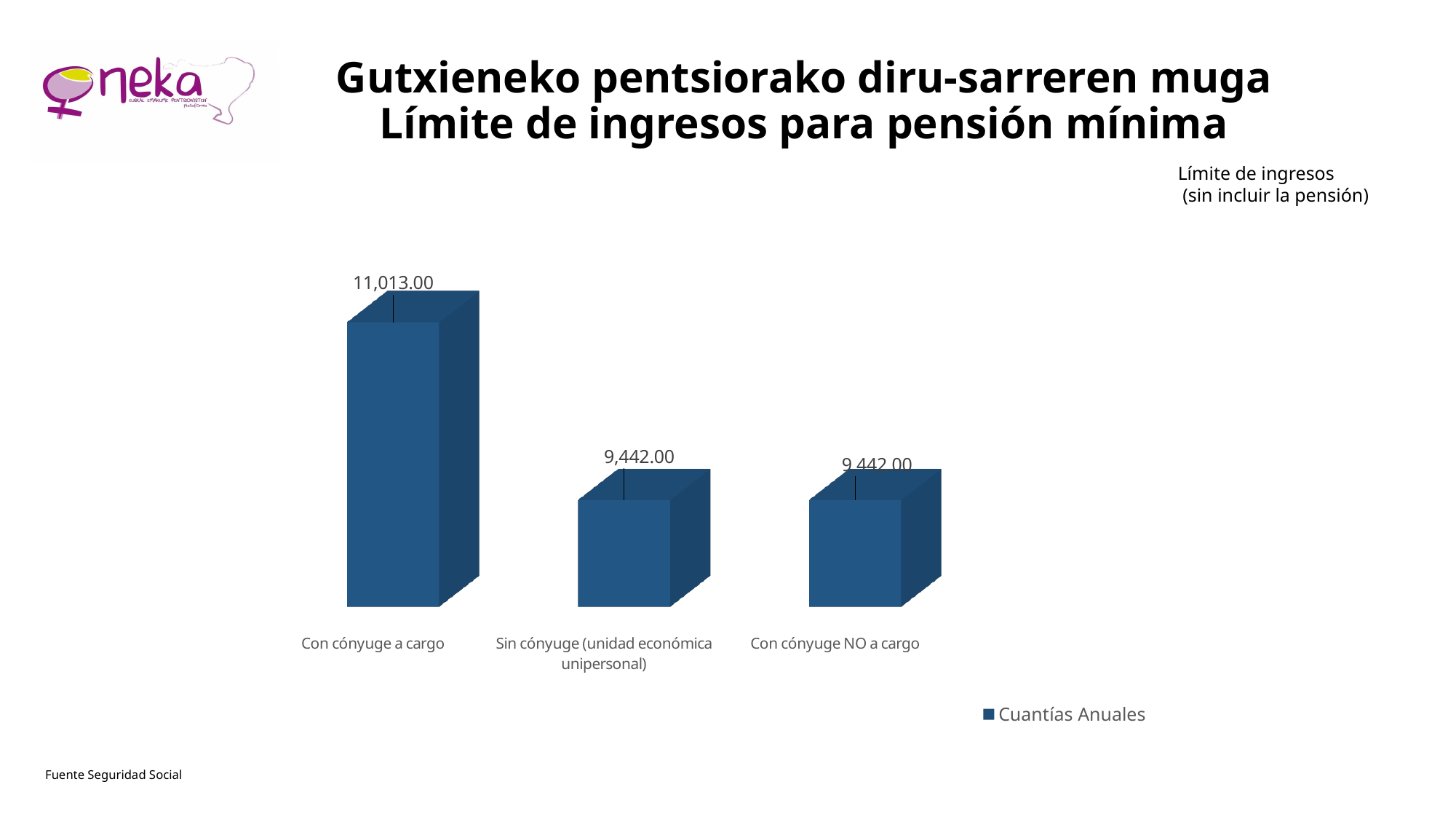
How many series does the legend list? 1 What is the value for "Con cónyuge NO a cargo"? 9,442.00 What is the value for "Sin cónyuge (unidad económica unipersonal)"? 9,442.00 What kind of chart is shown on the slide? Bar chart What source is cited at the bottom of the slide? Fuente Seguridad Social What is the difference between the values for "Con cónyuge a cargo" and "Con cónyuge NO a cargo"? 1,571.00 Which category has the highest value? Con cónyuge a cargo What is the value for "Con cónyuge a cargo"? 11,013.00 What is the name of the series shown in the legend? Cuantías Anuales Do the values for "Sin cónyuge (unidad económica unipersonal)" and "Con cónyuge NO a cargo" differ? No, both are 9,442.00 Which is larger, the value for "Con cónyuge a cargo" or the value for "Sin cónyuge (unidad económica unipersonal)"? Con cónyuge a cargo How many categories are shown in the chart? 3